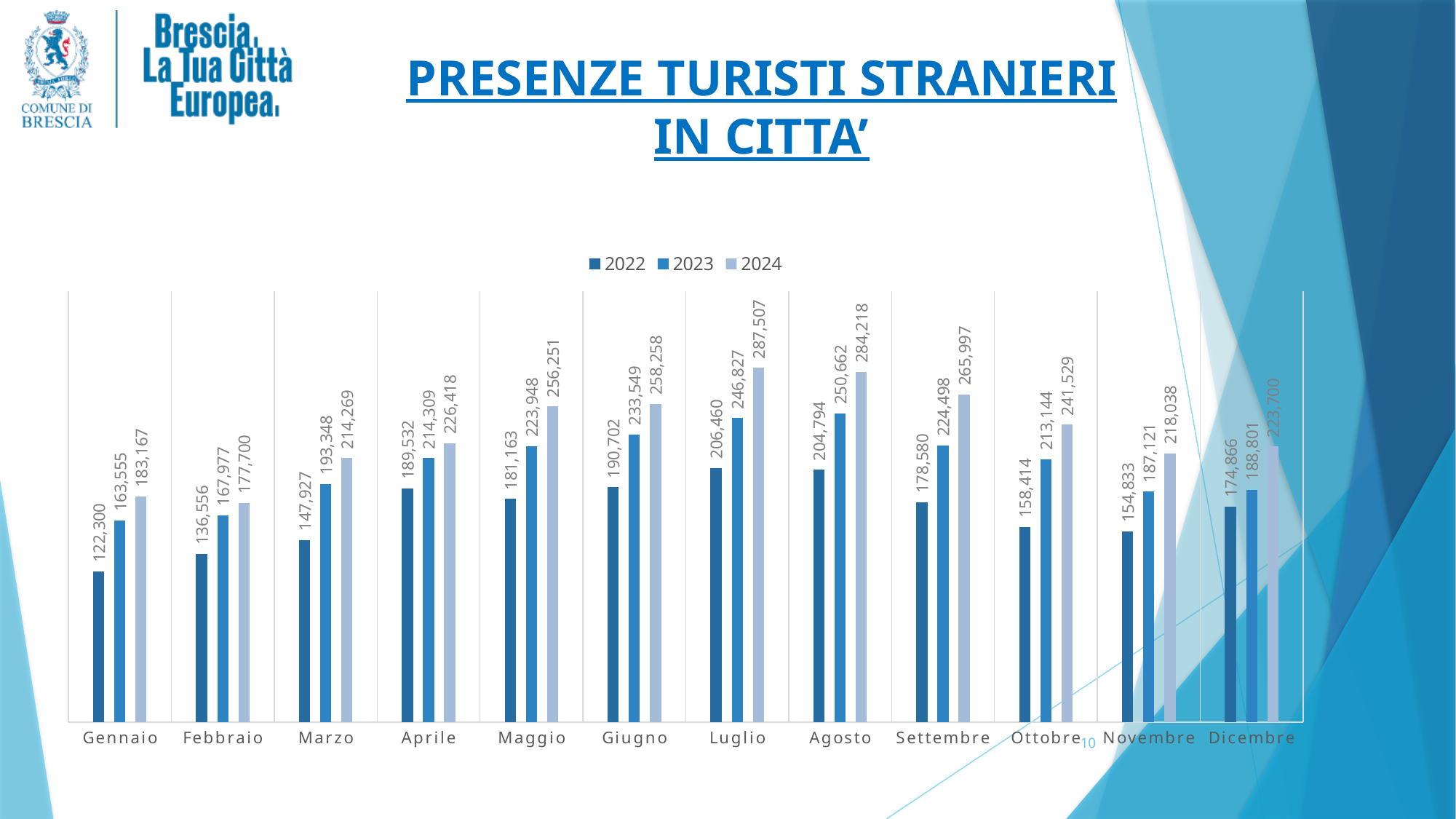
Which month has the lowest value for the 2022 series? Gennaio What is the value for 2023 in Settembre? 224,498 Which month has the highest value for the 2024 series? Luglio How many months are shown on the x axis? 12 What is the difference between the 2024 and 2023 values in Luglio? 40,680 What is the value for 2022 in Gennaio? 122,300 Which is larger: the 2023 value for Agosto or the 2023 value for Settembre? Agosto What kind of chart is shown on the slide? Bar chart What is the value for 2024 in Dicembre? 223,700 How many series does the legend list? 3 What is the value for 2024 in Luglio? 287,507 What is the difference between the 2024 and 2022 values in Gennaio? 60,867